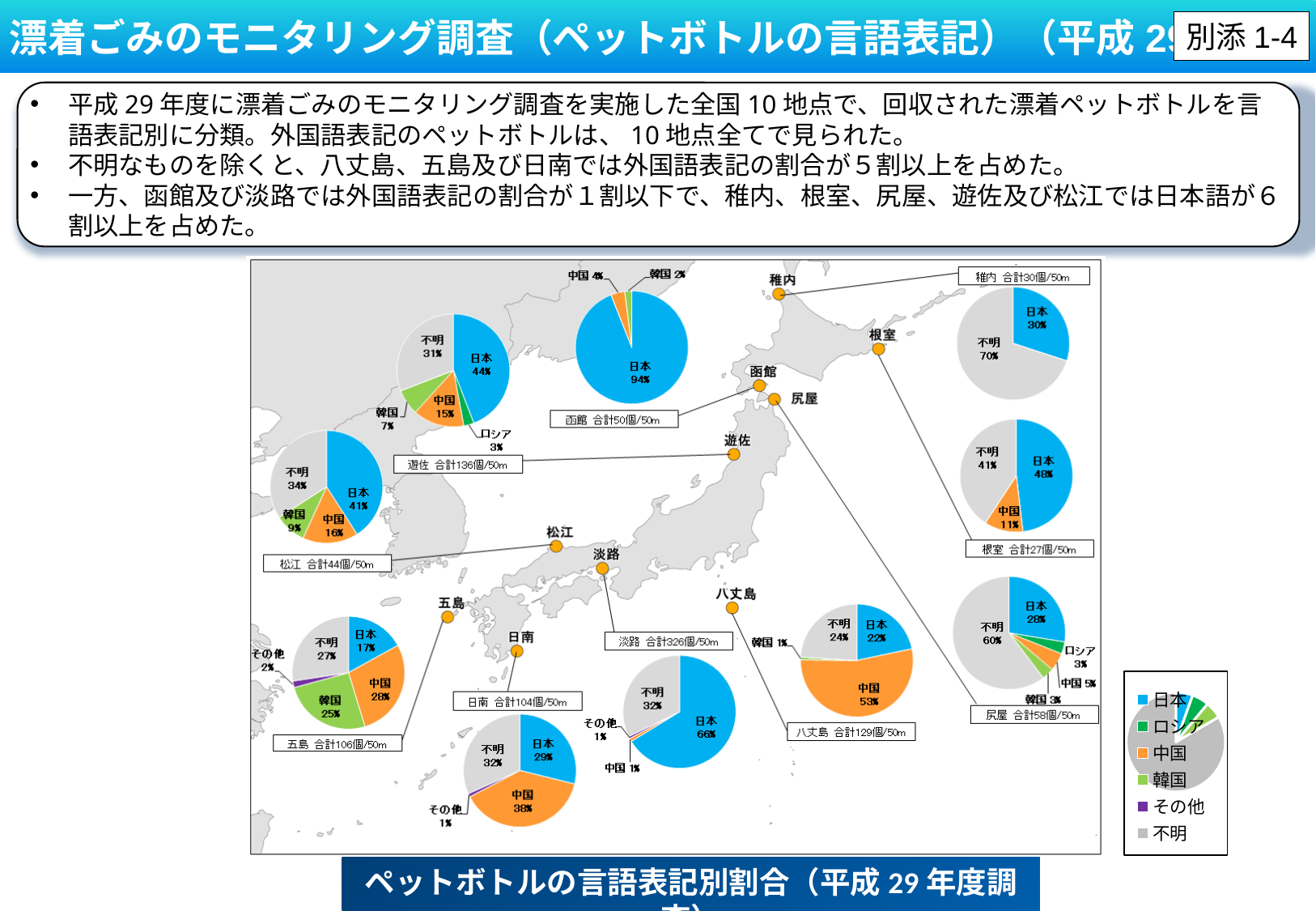
In the 遊佐 pie chart, which category has the smallest share? ロシア In the 八丈島 pie chart, what share is labelled 中国? 53% What total count is given in the label for 淡路? 合計326個/50m In the 稚内 pie chart, what share is labelled 不明? 70% In the 五島 pie chart, which category has the largest share? 中国 How many categories does the legend list? 6 In the 函館 pie chart, what share is labelled 日本? 94% In the 根室 pie chart, what share is labelled 中国? 11% In the 松江 pie chart, which is larger, the 中国 share or the 韓国 share? 中国 In the 日南 pie chart, what is the difference between the 中国 share and the 日本 share? 9% What kind of charts are shown on the map? Pie charts How many slices does the 尻屋 pie chart have? 5